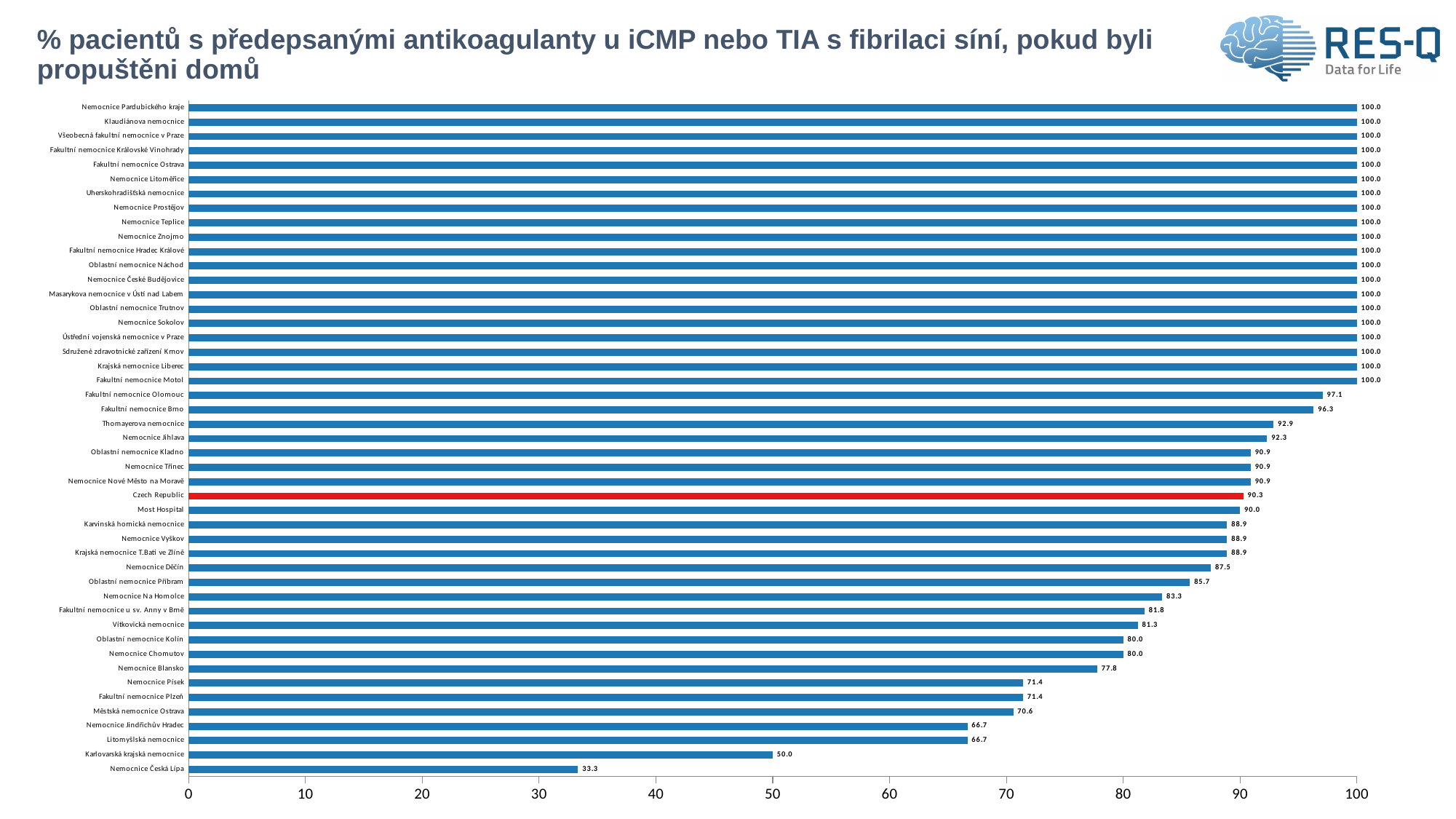
Is the value for Městská nemocnice Ostrava greater or less than 80? less Which bar is highlighted in red? Czech Republic Which hospital has the lowest value? Nemocnice Česká Lípa What is the value for Fakultní nemocnice Olomouc? 97.1 How many bars are shown in the chart? 47 What is the value for Karlovarská krajská nemocnice? 50.0 How many hospitals have a value of 100.0? 20 What is the value for Czech Republic? 90.3 Which has a larger value, Nemocnice Děčín or Oblastní nemocnice Příbram? Nemocnice Děčín What is the value for Nemocnice Česká Lípa? 33.3 What is the difference between the values for Fakultní nemocnice Brno and Nemocnice Blansko? 18.5 What kind of chart is shown on the slide? bar chart